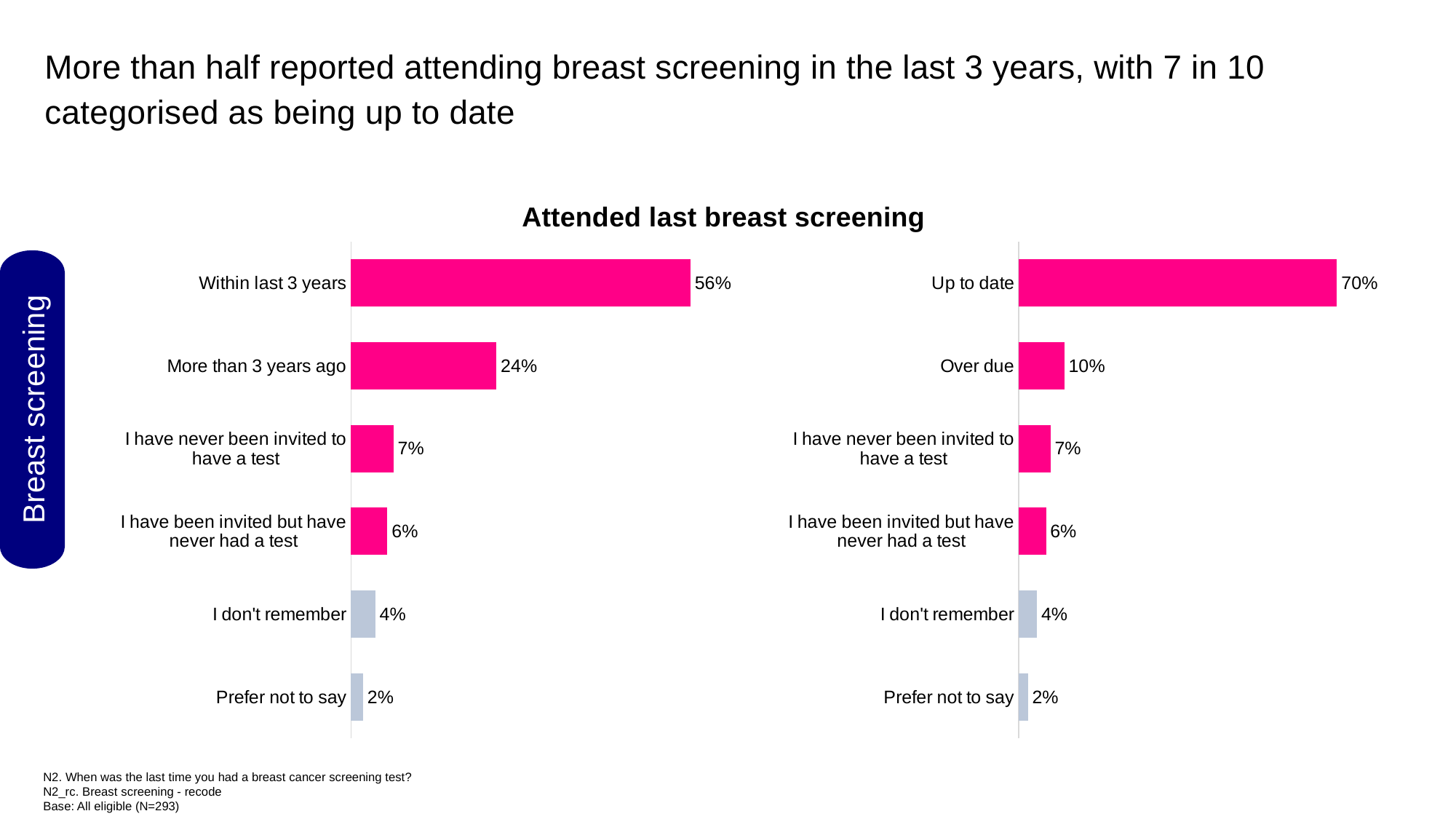
How many categories are shown in the left chart? 6 What is the title shown above the charts? Attended last breast screening In the left chart, what percentage reported attending breast screening within the last 3 years? 56% In the right chart, what is the difference between 'Up to date' and 'Over due'? 60 percentage points In the right chart, what percentage are categorised as over due? 10% In the left chart, what is the difference between 'Within last 3 years' and 'More than 3 years ago'? 32 percentage points In the left chart, what percentage said 'More than 3 years ago'? 24% In the right chart, which category has the lowest value? Prefer not to say In the left chart, which is larger: 'I have never been invited to have a test' or 'I have been invited but have never had a test'? I have never been invited to have a test What type of chart is used on this slide? Bar chart In the right chart, what percentage are categorised as up to date? 70% In the left chart, which category has the highest value? Within last 3 years